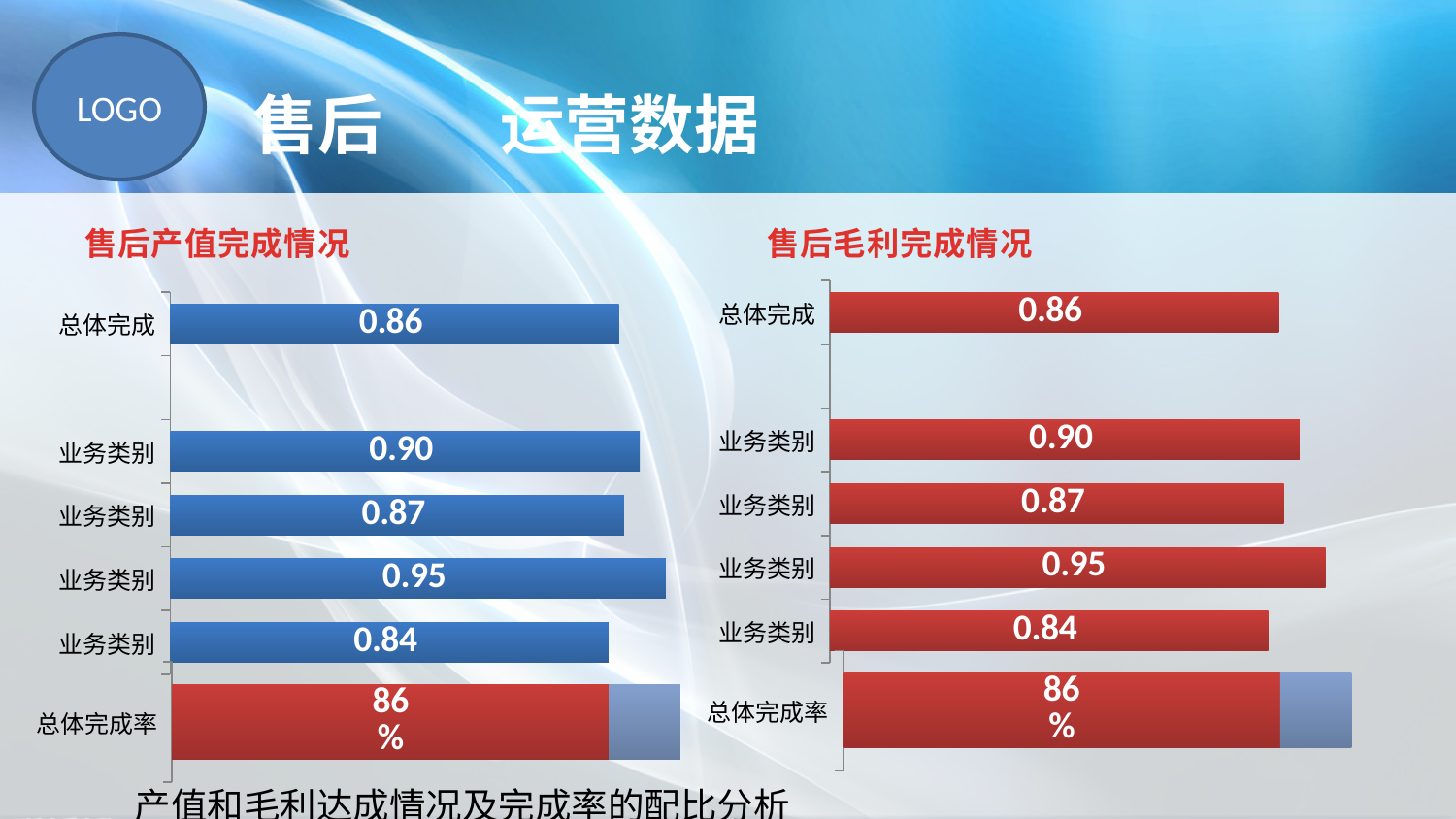
In the left chart titled 售后产值完成情况, how many bars are labeled 业务类别? 4 In the right chart titled 售后毛利完成情况, what is the value of the bottom 业务类别 bar? 0.84 In the left chart titled 售后产值完成情况, what is the value of the topmost 业务类别 bar? 0.90 What is the title of the right chart? 售后毛利完成情况 In the right chart titled 售后毛利完成情况, what percentage is shown for 总体完成率? 86% In the right chart titled 售后毛利完成情况, what is the highest value among the 业务类别 bars? 0.95 In the left chart titled 售后产值完成情况, what is the value for 总体完成? 0.86 In the left chart titled 售后产值完成情况, what is the lowest value among the 业务类别 bars? 0.84 What kind of chart is the left chart titled 售后产值完成情况? Bar chart In the right chart titled 售后毛利完成情况, which is larger: the topmost 业务类别 bar or the second 业务类别 bar from the top? The topmost 业务类别 bar (0.90) What colour are the bars in the left chart titled 售后产值完成情况? Blue In the left chart titled 售后产值完成情况, what is the difference between the highest 业务类别 value (0.95) and the lowest 业务类别 value (0.84)? 0.11